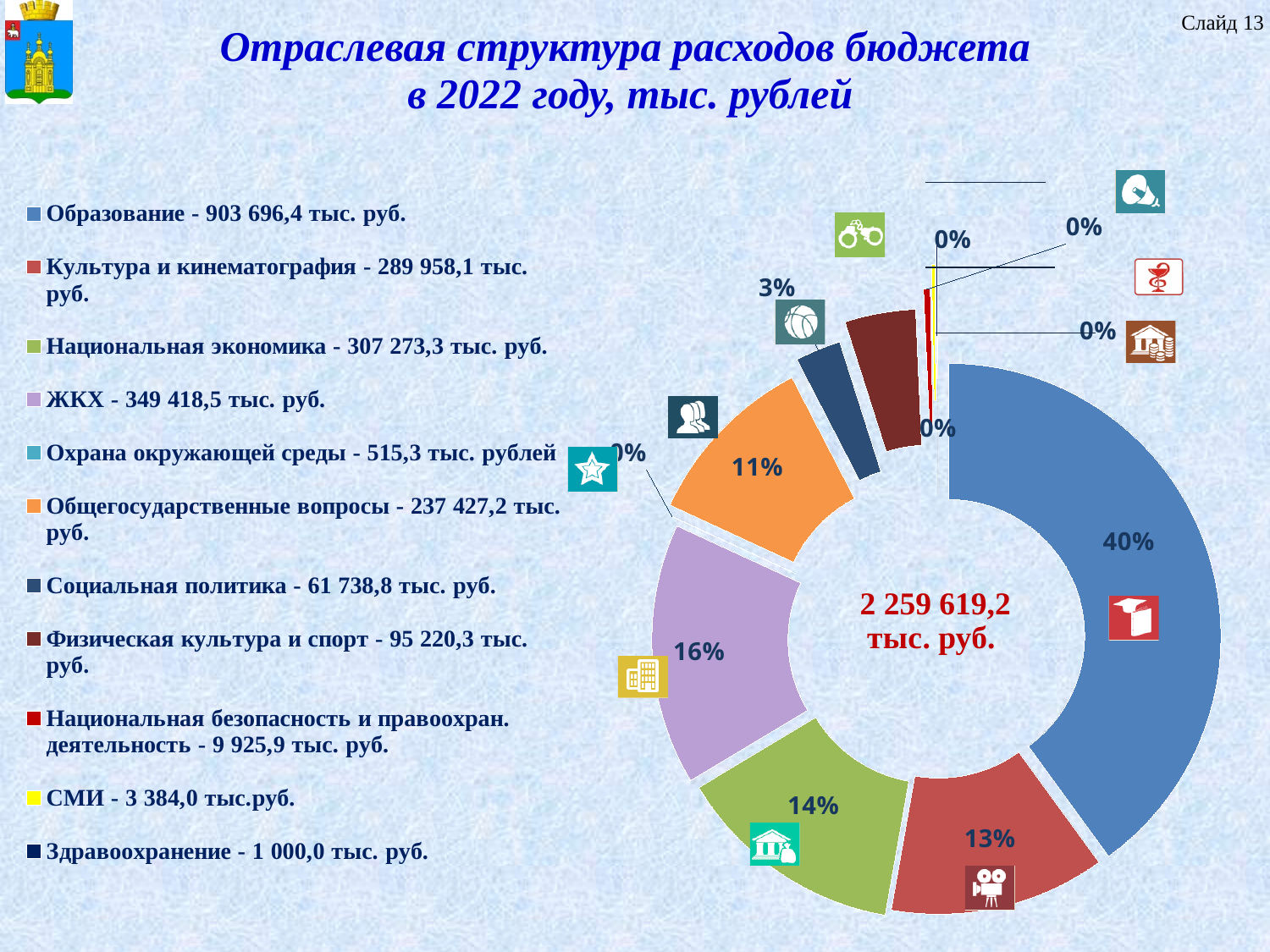
Which category has the highest value? Образование What kind of chart is shown on the slide? pie chart (doughnut) What is the difference between Национальная экономика and Культура и кинематография? 17 315,2 тыс. руб. Which is larger, ЖКХ or Национальная экономика? ЖКХ Which category has the lowest value? Здравоохранение How many categories does the legend list? 11 What is the title of the chart? Отраслевая структура расходов бюджета в 2022 году, тыс. рублей What is the value for СМИ? 3 384,0 тыс.руб. What share of the pie does ЖКХ take? 16% What share of the pie does Образование take? 40% What is the value for Образование? 903 696,4 тыс. руб. What total is shown in the centre of the chart? 2 259 619,2 тыс. руб.